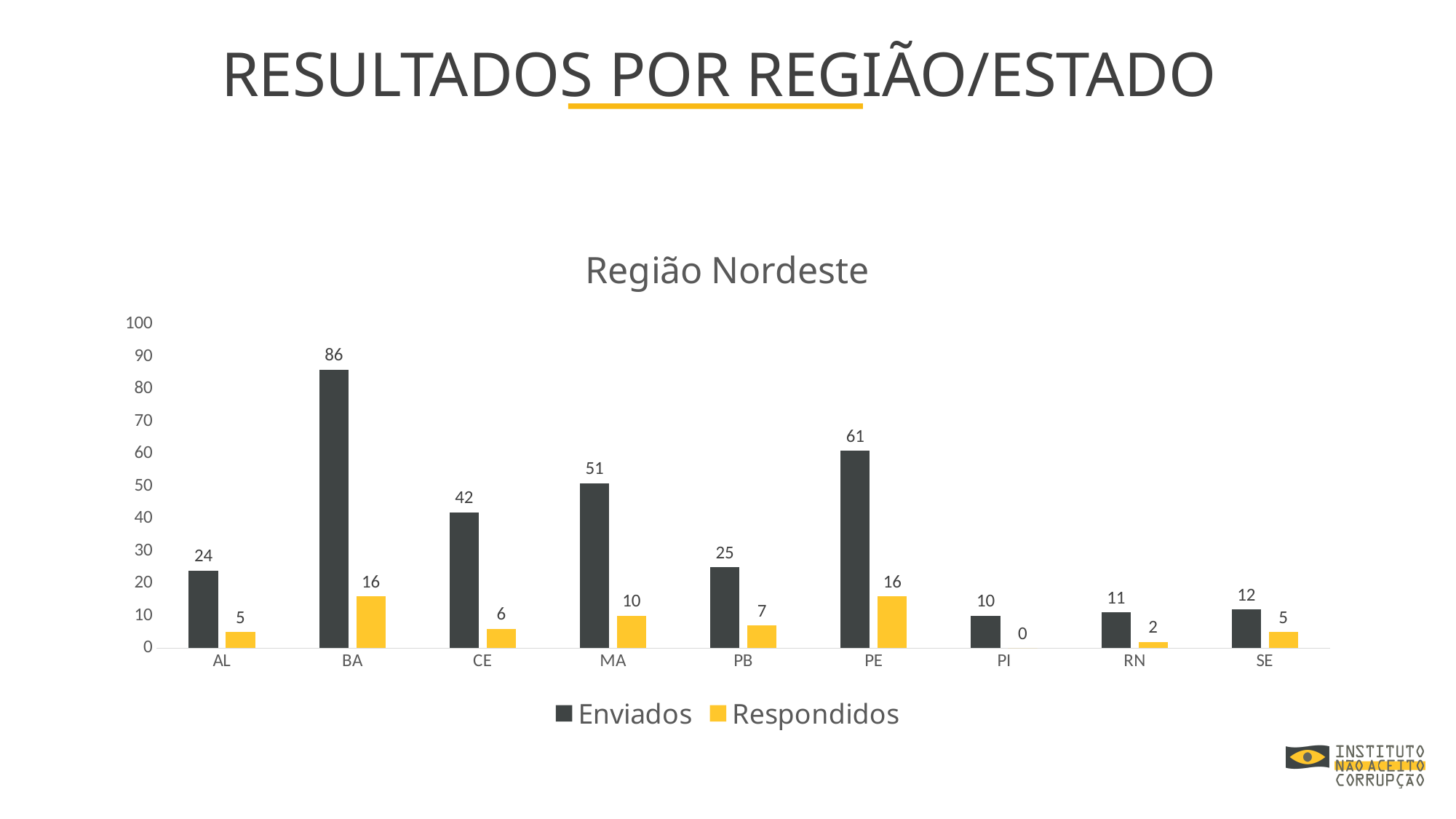
How many series does the legend list? 2 What is the Respondidos value for PI? 0 What is the title of the chart? Região Nordeste What kind of chart is shown? bar chart What is the difference between Enviados and Respondidos for PE? 45 What is the Enviados value for BA? 86 Which state has the highest Enviados value? BA Which is larger, the Enviados value for CE or the Enviados value for MA? MA Is the Enviados value for PE greater or less than 50? greater What is the Respondidos value for MA? 10 Which state has the lowest Enviados value? PI How many states are shown on the x axis? 9